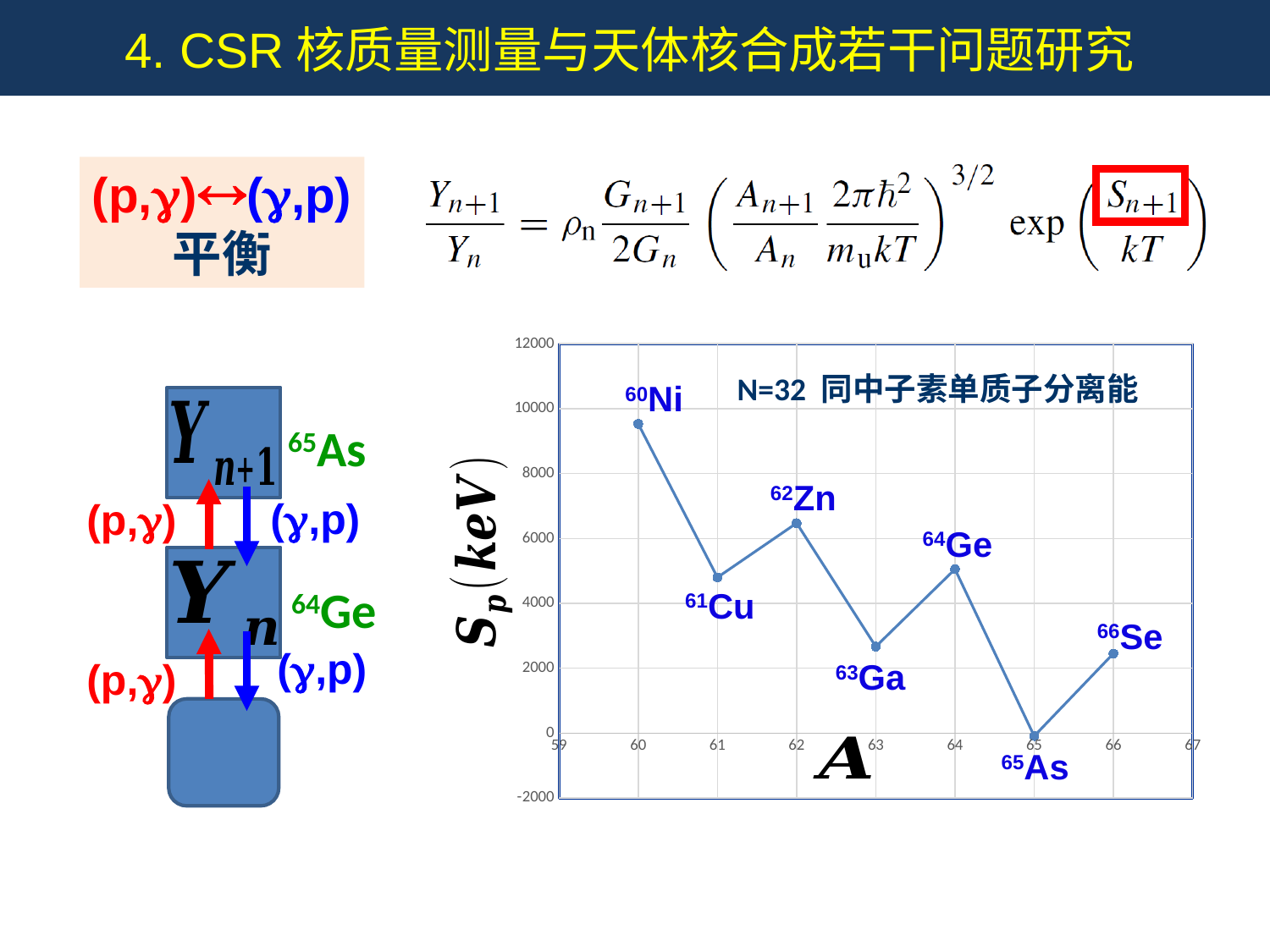
Does the value rise or fall from A=60 to A=61? fall Which has a larger Sp value, 62Zn or 61Cu? 62Zn What kind of chart is shown on the slide? line chart Is the value for 63Ga greater or less than 4000? less What is the title of the chart? N=32 同中子素单质子分离能 How many data points are plotted on the chart? 7 Is the value for 64Ge greater or less than 4000? greater What is the label of the y axis? Sp (keV) Which nucleus has the lowest proton separation energy Sp on the chart? 65As Which has a larger Sp value, 64Ge or 66Se? 64Ge Is the value for 60Ni greater or less than 8000? greater Which nucleus has the highest proton separation energy Sp on the chart? 60Ni